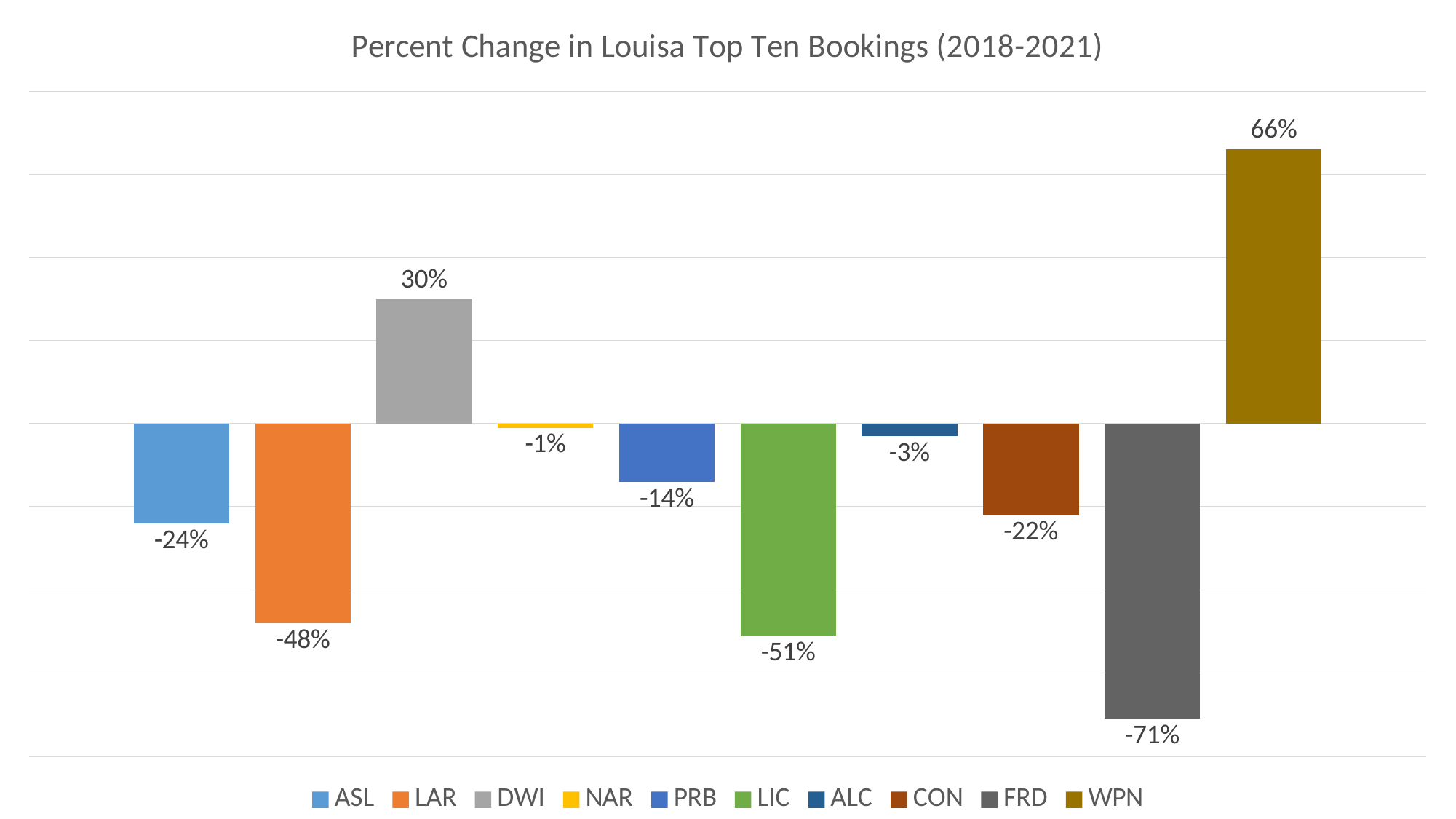
What is the percent change for DWI? 30% What is the title of the chart? Percent Change in Louisa Top Ten Bookings (2018-2021) What is the difference between the percent change for WPN and DWI? 36 percentage points What is the percent change for LIC? -51% Which category has the lowest percent change? FRD Which has a larger percent change, ASL or CON? CON What is the percent change for FRD? -71% How many categories show a positive percent change? 2 How many categories are shown in the chart? 10 What kind of chart is this? Bar chart Which category has the highest percent change? WPN How many entries does the legend list? 10